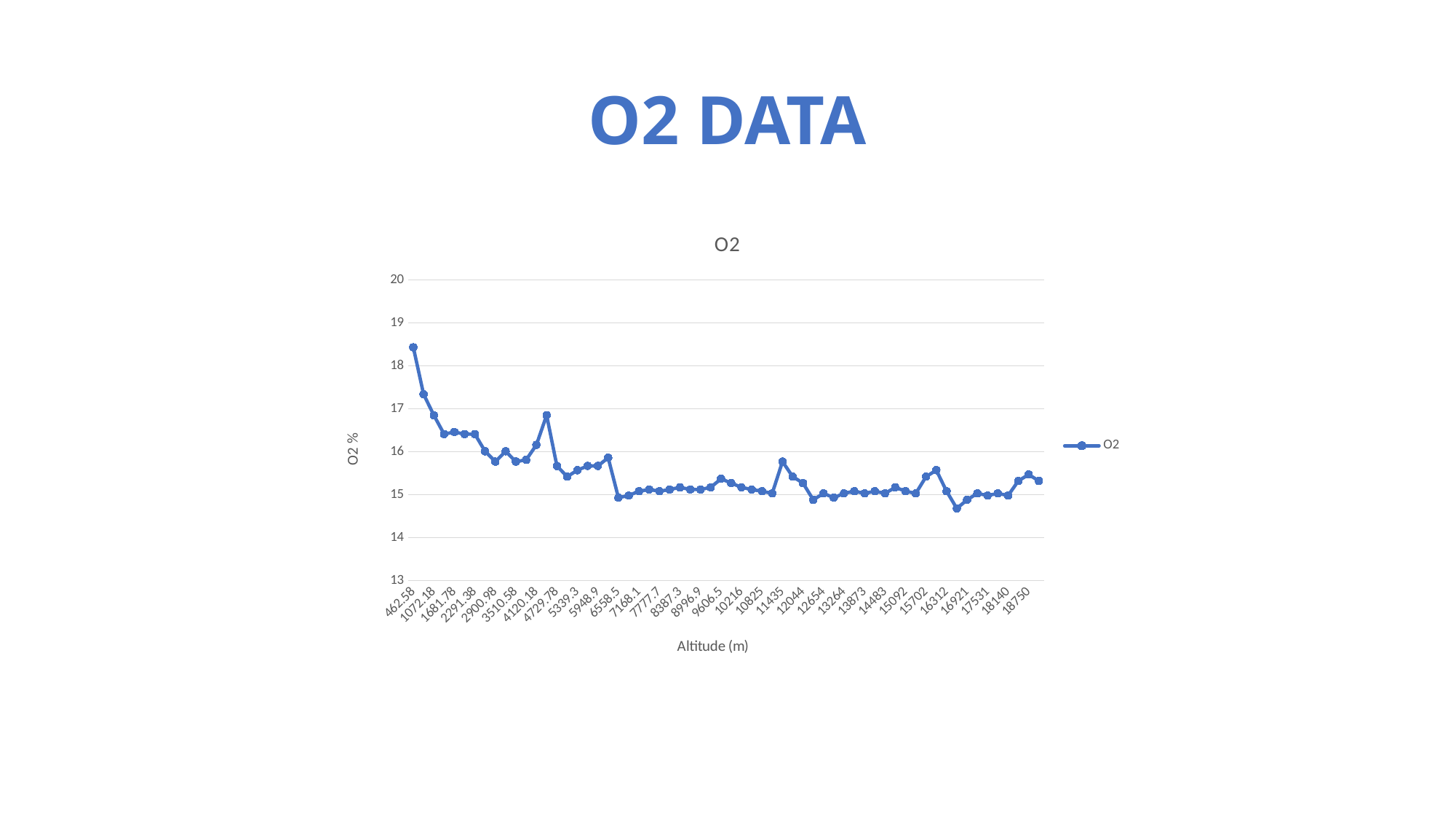
Which has the larger O2 value, altitude 4729.78 or altitude 6558.5? 4729.78 What is the title of the chart? O2 What kind of chart is shown on the slide? line chart Overall, do the O2 values rise or fall as altitude increases along the x axis? fall What is the label of the x axis? Altitude (m) How many series does the legend list? 1 At which altitude is the O2 value highest? 462.58 Is the O2 value at altitude 16921 greater or less than 15? less Is the O2 value at altitude 462.58 greater or less than 18? greater Which has the larger O2 value, altitude 462.58 or altitude 18750? 462.58 Is the O2 value at altitude 4729.78 greater or less than 16? less